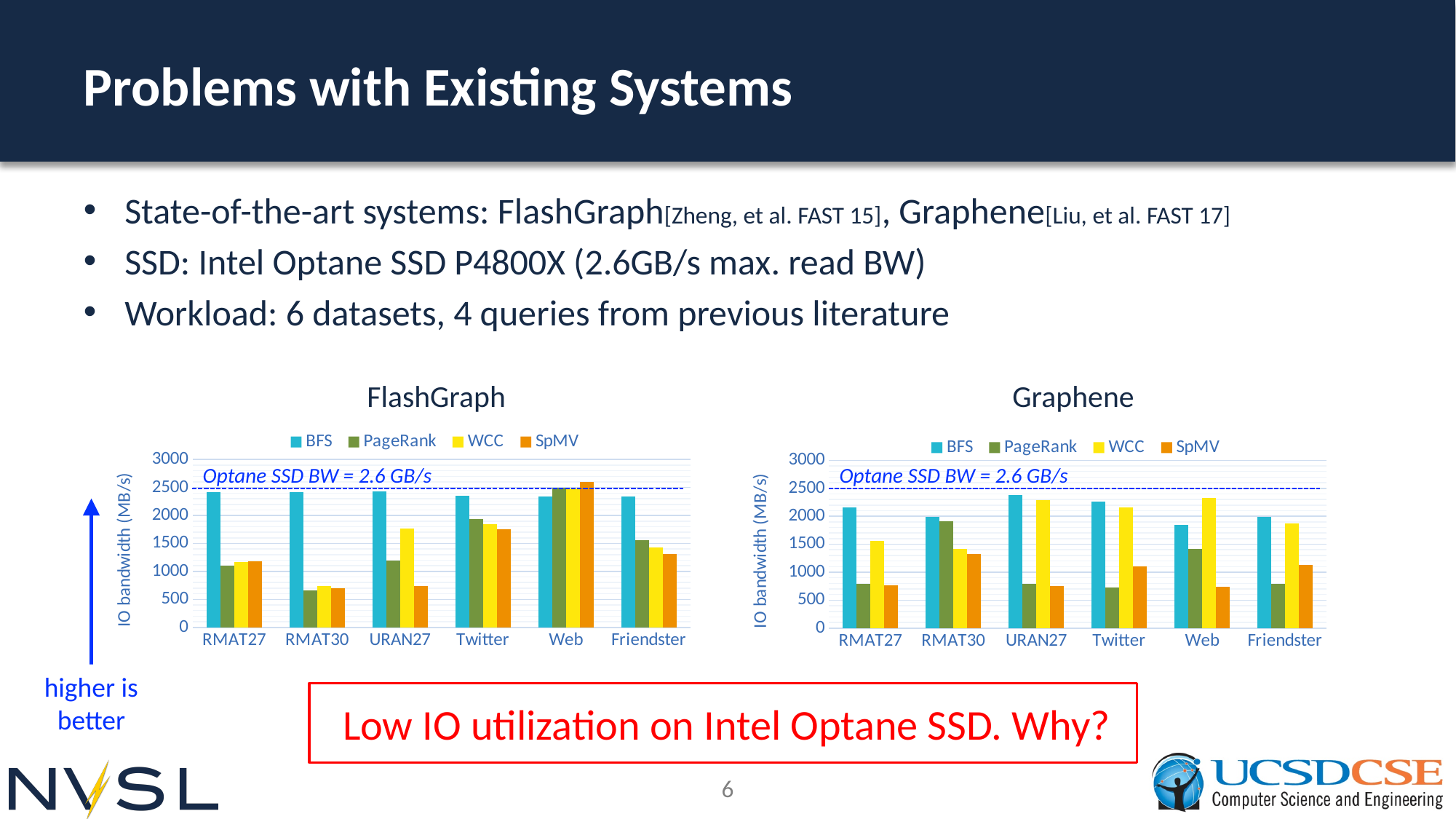
How many datasets (categories) are shown on the x axis of the Graphene chart? 6 How many series does the legend of the FlashGraph chart list? 4 What kind of chart is the FlashGraph chart? bar chart In the Graphene chart, which is larger for Twitter: WCC or SpMV? WCC In the FlashGraph chart, which is larger for RMAT27: BFS or PageRank? BFS What does the dashed horizontal line in the FlashGraph chart represent, according to its label? Optane SSD BW = 2.6 GB/s In the FlashGraph chart, is the BFS value for RMAT27 greater or less than 2000? greater In the FlashGraph chart, is the PageRank value for RMAT30 greater or less than 1000? less In the Graphene chart, which series has the lowest value for Twitter? PageRank In the FlashGraph chart, which series has the highest value for Friendster? BFS In the Graphene chart, is the SpMV value for Web greater or less than 1000? less